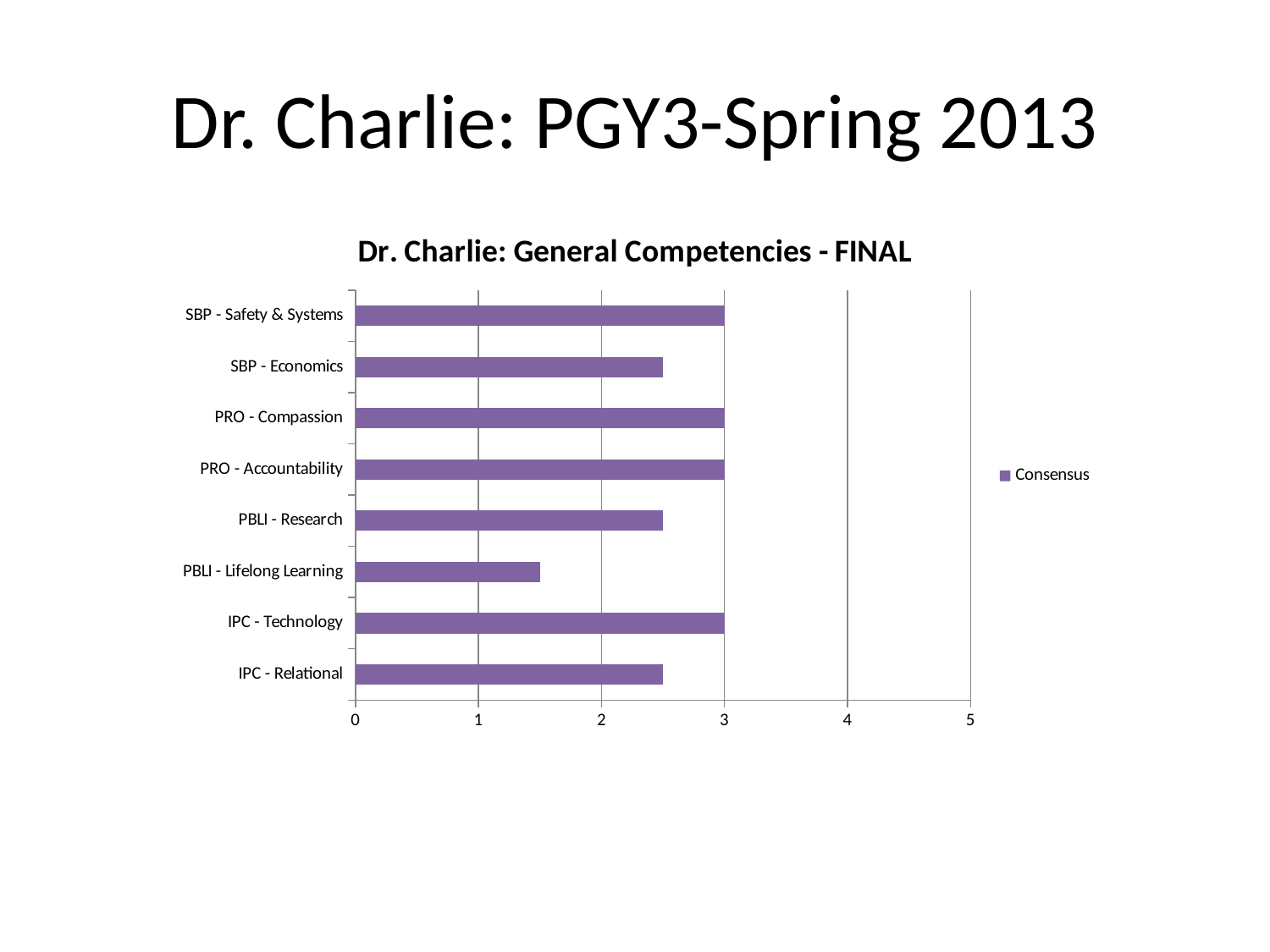
Which category has the lowest Consensus value? PBLI - Lifelong Learning What is the title of the chart? Dr. Charlie: General Competencies - FINAL What is the name of the series shown in the legend? Consensus Which is larger, the value for PRO - Compassion or the value for PBLI - Lifelong Learning? PRO - Compassion What kind of chart is shown on the slide? bar chart How many series does the legend list? 1 How many categories are plotted on the chart? 8 Is the value for PBLI - Lifelong Learning greater or less than 2? less Is the value for SBP - Economics greater or less than 2? greater What is the Consensus value for SBP - Safety & Systems? 3 What is the Consensus value for IPC - Technology? 3 Is the value for PBLI - Research greater or less than 3? less